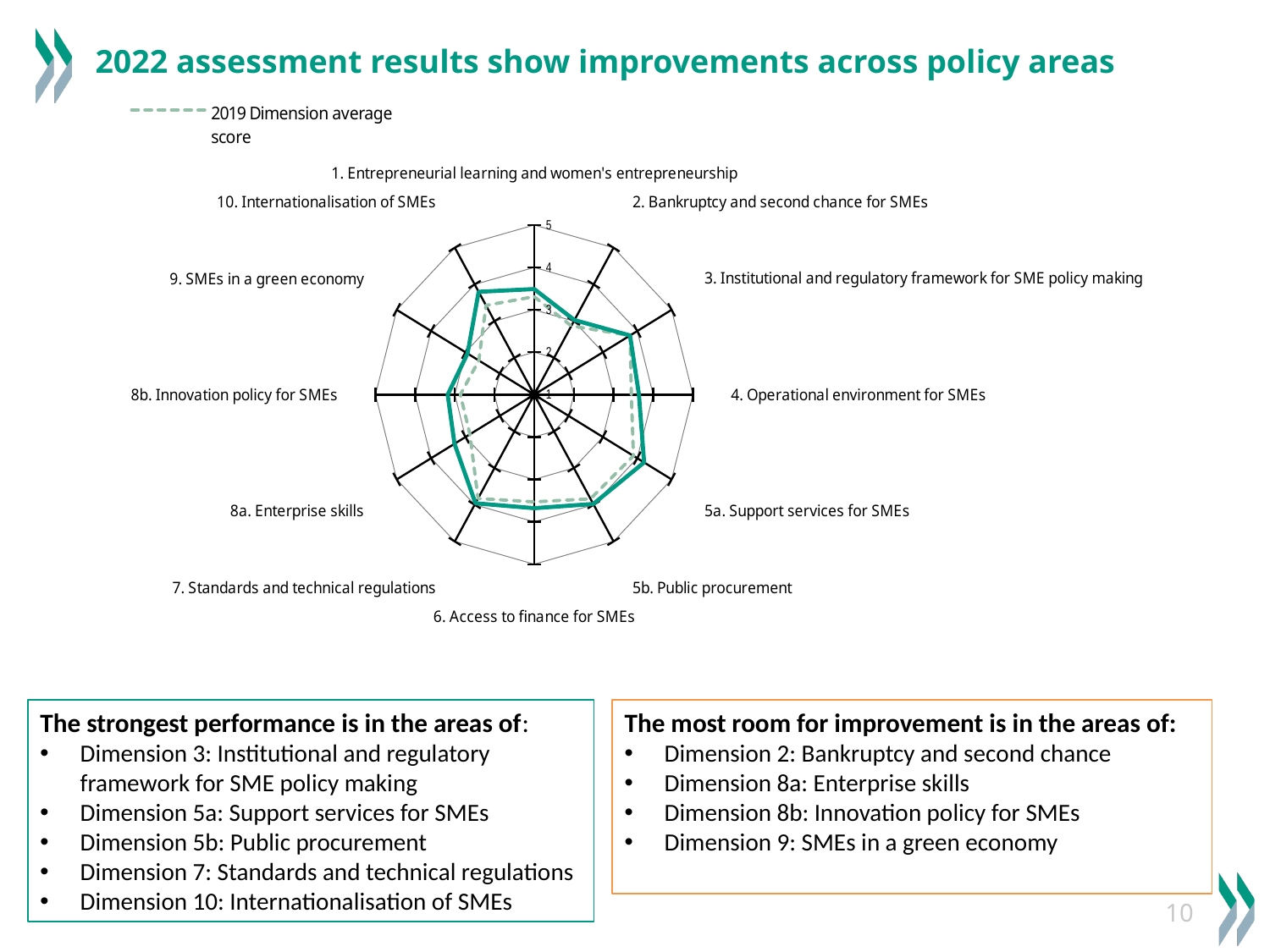
What legend entry is shown for the dashed line on the chart? 2019 Dimension average score Is the solid-line value for '3. Institutional and regulatory framework for SME policy making' greater or less than 3? greater How many policy dimensions (categories) are plotted on the radar chart? 12 Is the solid-line value for '10. Internationalisation of SMEs' greater or less than 4? less What kind of chart is shown on the slide? Radar chart Is the solid-line value for '8a. Enterprise skills' greater or less than 2? greater What is the highest value marked on the radial axis of the chart? 5 Which has the larger solid-line value: '3. Institutional and regulatory framework for SME policy making' or '9. SMEs in a green economy'? 3. Institutional and regulatory framework for SME policy making Which has the larger solid-line value: '5a. Support services for SMEs' or '8b. Innovation policy for SMEs'? 5a. Support services for SMEs